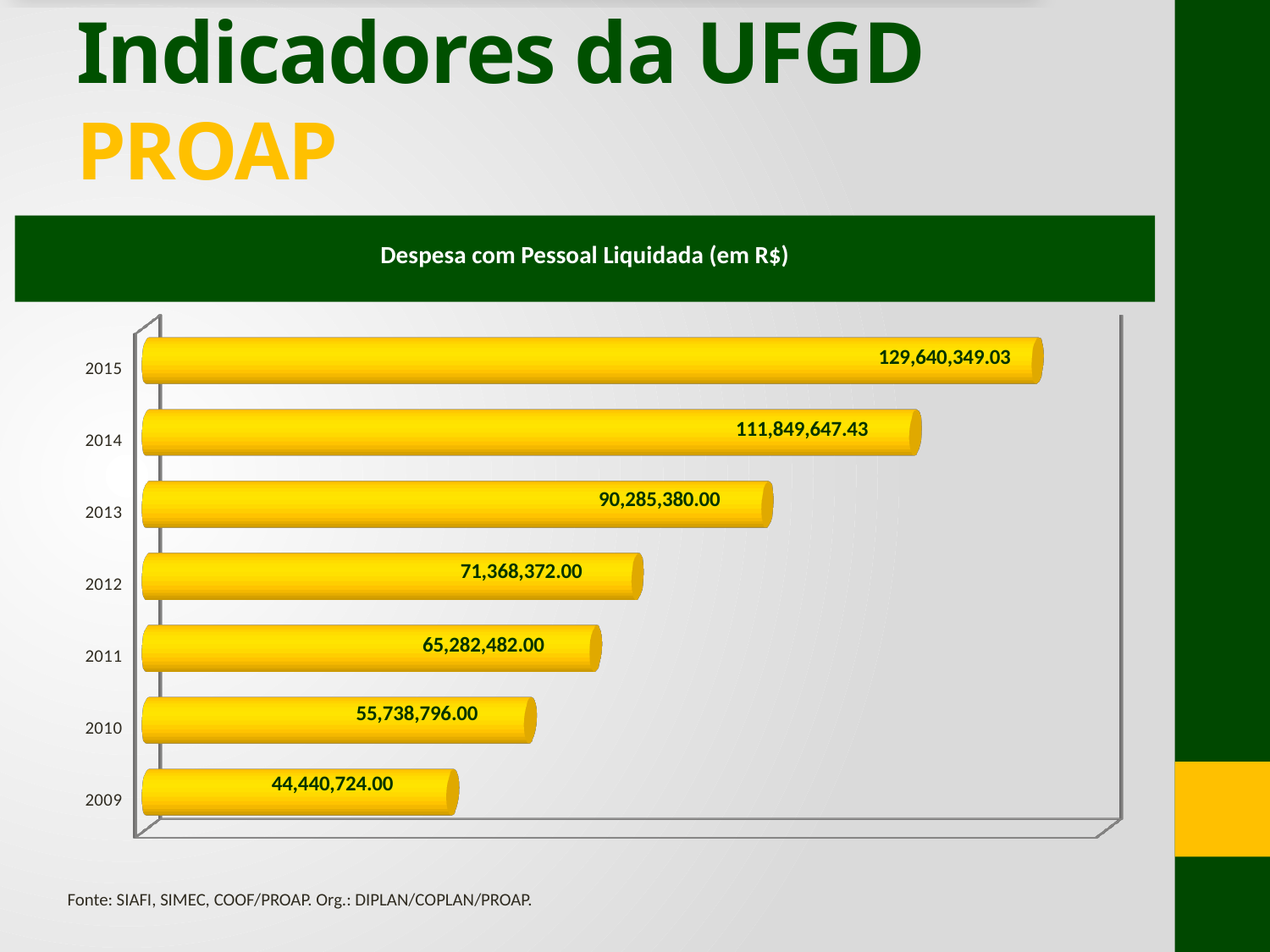
How many years are shown in the chart? 7 Which is larger, the value for 2011 or the value for 2010? 2011 What is the value for 2013 in the chart? 90,285,380.00 Do the values rise or fall from 2009 to 2015? rise Which year has the highest value in the chart? 2015 What kind of chart is shown on the slide? bar chart What is the difference between the values for 2010 and 2009? 11,298,072.00 What is the value for 2009 in the chart? 44,440,724.00 What is the value for 2015 in the chart? 129,640,349.03 What is the value for 2012 in the chart? 71,368,372.00 Which year has the lowest value in the chart? 2009 What is the difference between the values for 2015 and 2014? 17,790,701.60